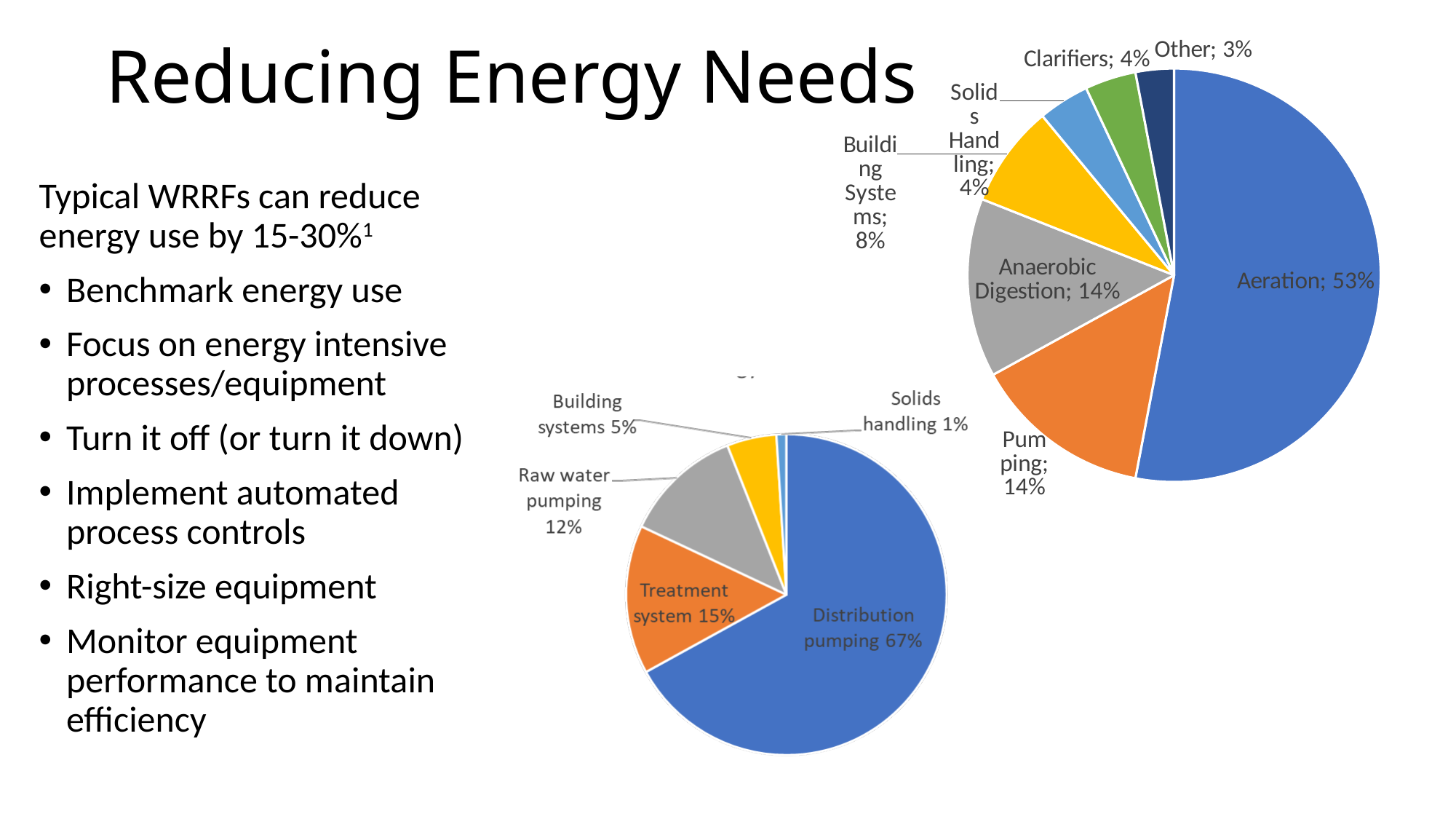
In the upper-right pie chart, which category has the smallest slice? Other In the upper-right pie chart, how many slices are there? 7 What type of chart is the lower chart on the slide? Pie chart In the lower pie chart, what share does Distribution pumping have? 67% In the upper-right pie chart, what is the difference between the Aeration share and the Pumping share? 39% In the lower pie chart, which is larger: Treatment system or Building systems? Treatment system In the upper-right pie chart, which category has the largest slice? Aeration In the upper-right pie chart, what share does Anaerobic Digestion have? 14% In the upper-right pie chart, what share does Aeration have? 53% In the lower pie chart, how many slices are there? 5 In the lower pie chart, what share does Raw water pumping have? 12% In the lower pie chart, which category has the smallest slice? Solids handling